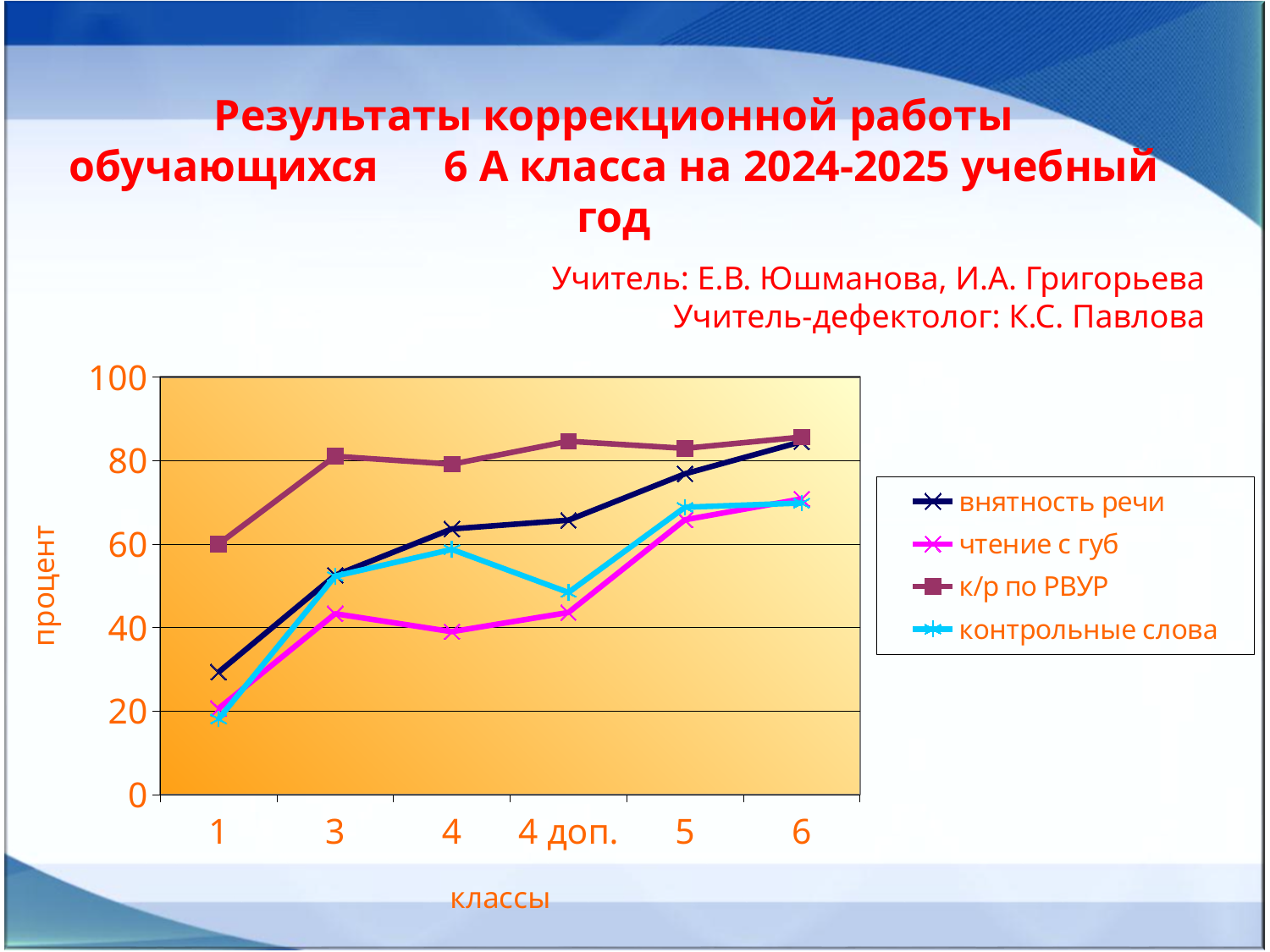
How many series does the legend list? 4 Which series has the highest value at class 1? к/р по РВУР Is the value for контрольные слова at class 4 доп. greater or less than 60? less What is the label of the horizontal axis? классы Is the value for к/р по РВУР at class 3 greater or less than 60? greater At class 4 доп., which is larger: внятность речи or чтение с губ? внятность речи Which series has the lowest value at class 4? чтение с губ Is the value for внятность речи at class 1 greater or less than 40? less How many categories are shown on the x axis? 6 What is the label of the vertical axis? процент Does the внятность речи series rise or fall from class 1 to class 6? rises What kind of chart is shown on the slide? line chart